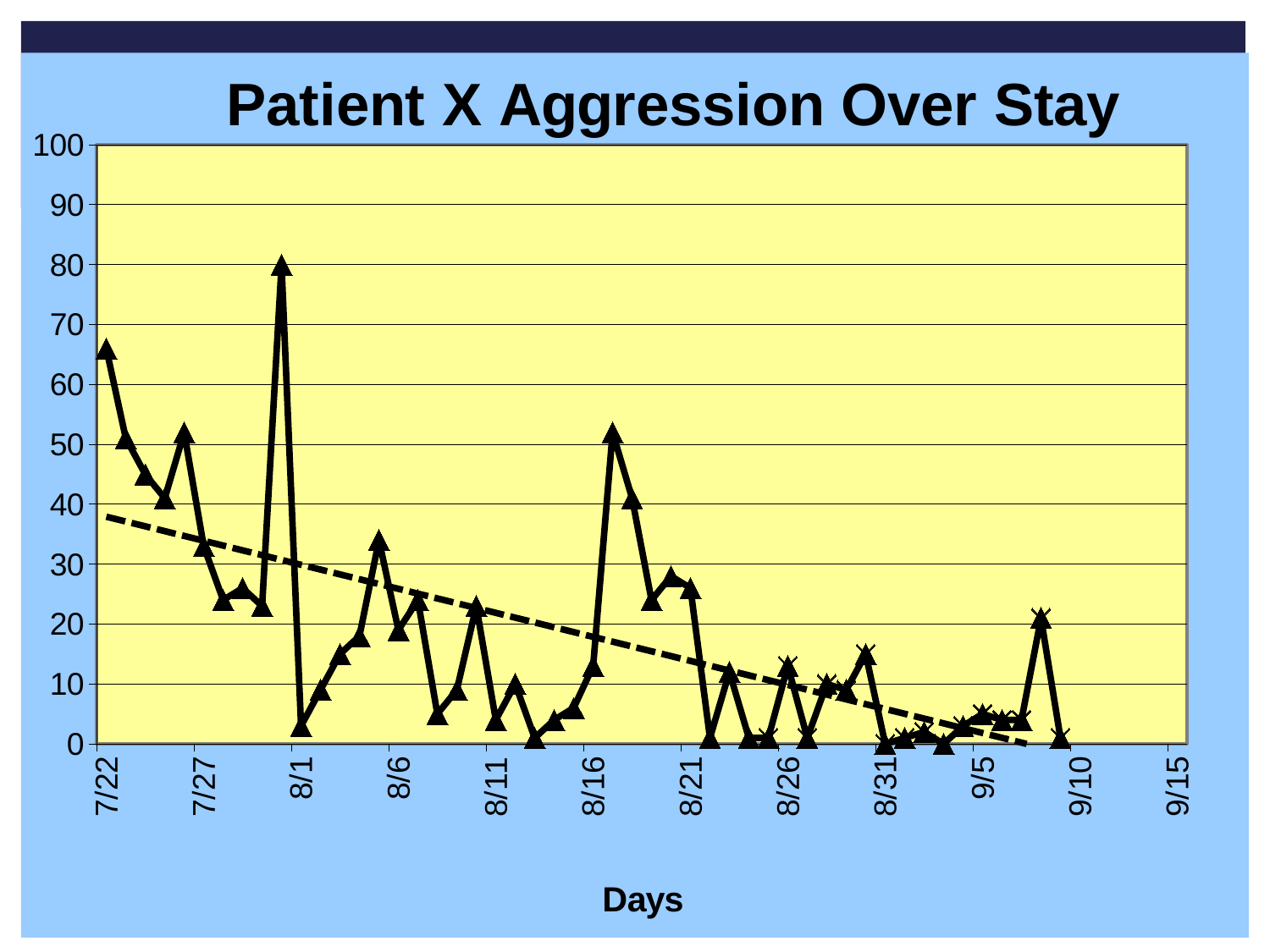
Is the value for 8/17 greater or less than 40? greater Which is larger, the value for 7/22 or the value for 8/17? 7/22 What is the title of the chart? Patient X Aggression Over Stay What is the highest value shown on the y axis? 100 Is the peak near 9/8 greater or less than 30? less What is the label on the x axis of the chart? Days Is the value for 7/22 greater or less than 60? greater What kind of chart is shown on the slide? line chart Does the highest peak of the line occur before or after 8/1? before Overall, do the aggression values rise or fall from 7/22 to 9/10? fall